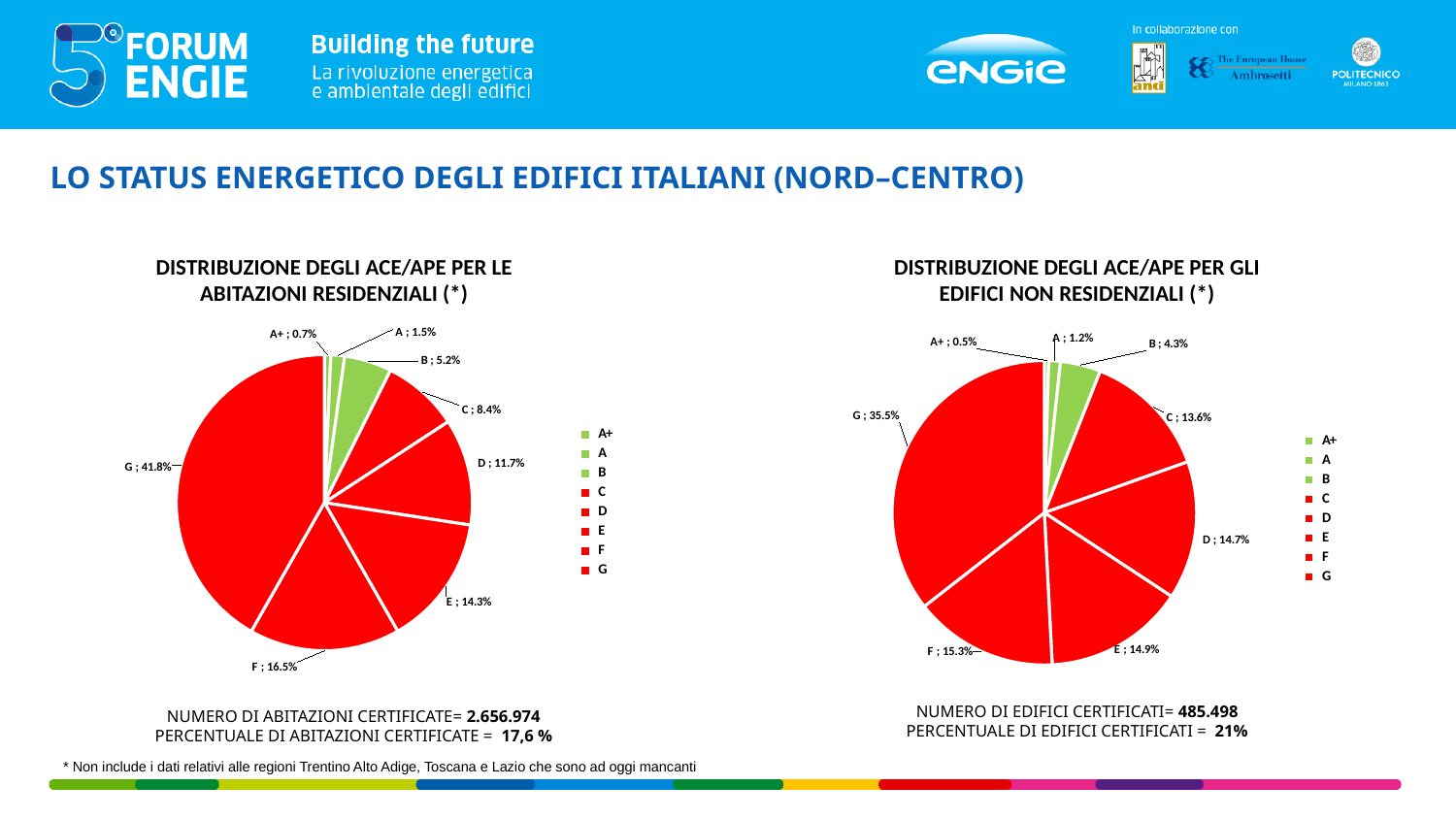
In the left chart (abitazioni residenziali), which class has the largest share? G In the right chart (edifici non residenziali), what share does class G have? 35.5% In the right chart (edifici non residenziali), which class has the smallest share? A+ In the left chart (abitazioni residenziali), what is the difference between the shares of class F and class E? 2.2% What type of chart is used for the distribution of ACE/APE for non-residential buildings? Pie chart What is the title of the left chart? DISTRIBUZIONE DEGLI ACE/APE PER LE ABITAZIONI RESIDENZIALI (*) How many entries does the legend of the right chart (edifici non residenziali) list? 8 How many slices does the left chart (abitazioni residenziali) have? 8 In the left chart (Distribuzione degli ACE/APE per le abitazioni residenziali), what share does class G have? 41.8% In the right chart (Distribuzione degli ACE/APE per gli edifici non residenziali), what share does class C have? 13.6% In the left chart (abitazioni residenziali), what is the combined share of classes A+ and A? 2.2% In the right chart (edifici non residenziali), which is larger, the share of class D or the share of class B? D